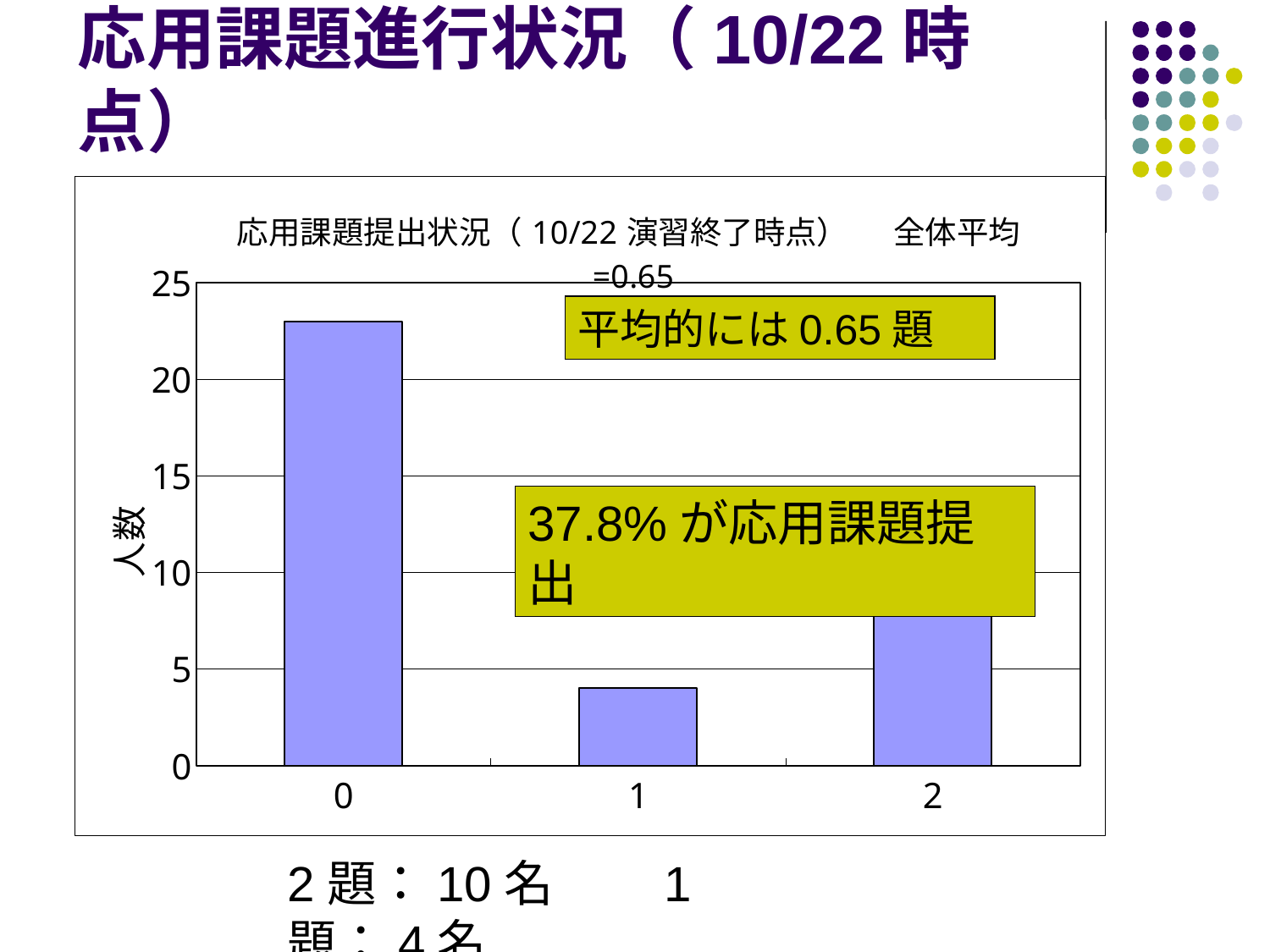
What overall average (全体平均) is stated in the chart title? 0.65 What kind of chart is shown on the slide? bar chart According to the slide, how many people (人数) are in category 2? 10 Which category has the highest bar in the chart? 0 What is the difference between the number of people in category 2 and category 1? 6 Is the value for category 1 greater or less than 5? less Which is larger, the bar for category 0 or the bar for category 2? 0 What is the label of the y axis of the chart? 人数 Which category has the lowest bar in the chart? 1 Is the value for category 0 greater or less than 20? greater How many categories are shown on the x axis of the chart? 3 According to the slide, how many people (人数) are in category 1? 4